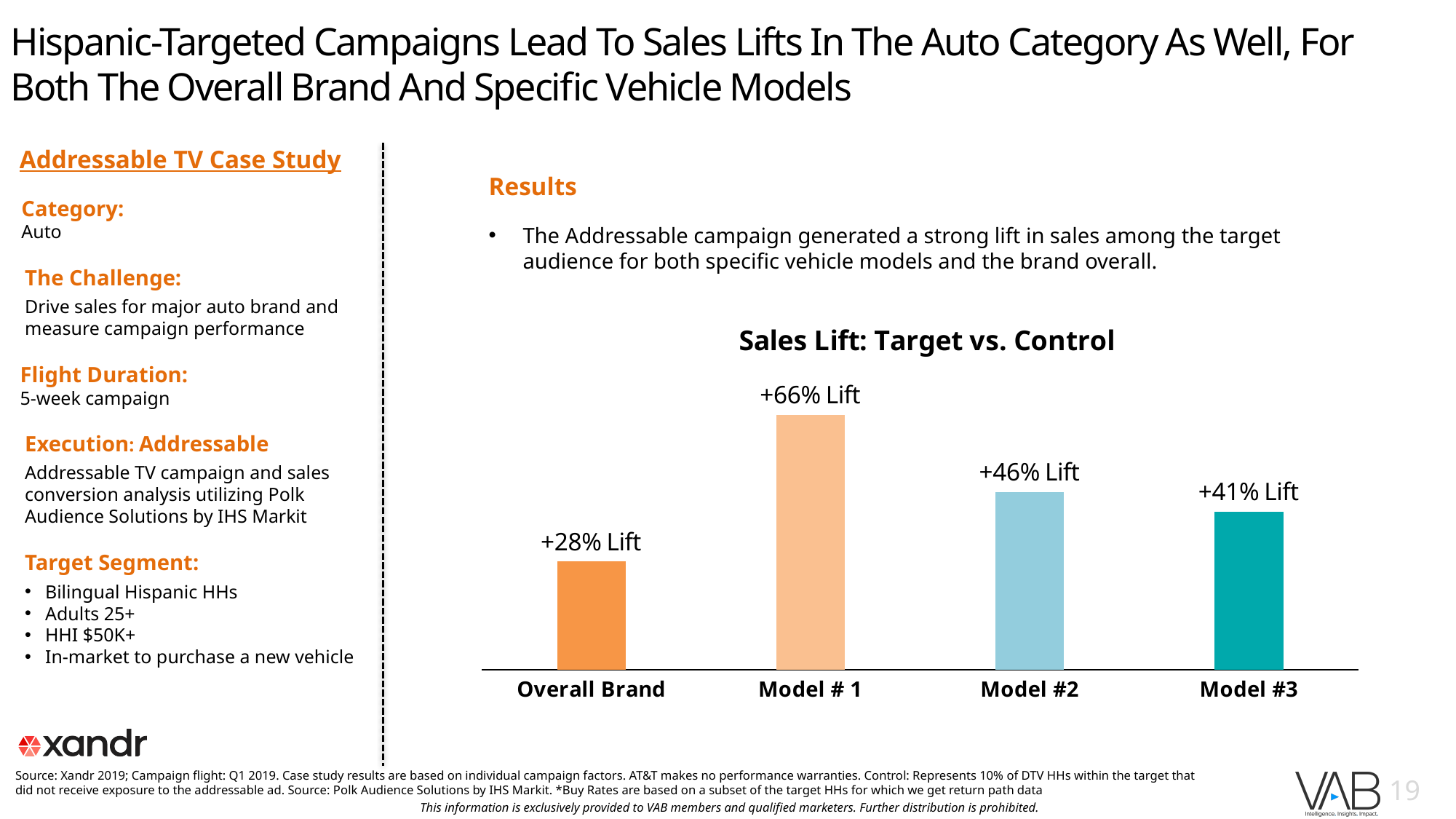
What is the sales lift shown for Model #3? +41% Lift Which category has the lowest sales lift? Overall Brand What is the title of the chart? Sales Lift: Target vs. Control Which has a larger sales lift, Model #2 or Model #3? Model #2 What is the difference in sales lift between Model # 1 and Overall Brand? 38 percentage points Which category has the highest sales lift? Model # 1 What is the difference in sales lift between Model #2 and Model #3? 5 percentage points What is the sales lift shown for Model # 1? +66% Lift How many categories are shown in the chart? 4 What kind of chart is shown on the slide? Bar chart What is the sales lift shown for Model #2? +46% Lift What is the sales lift shown for Overall Brand? +28% Lift